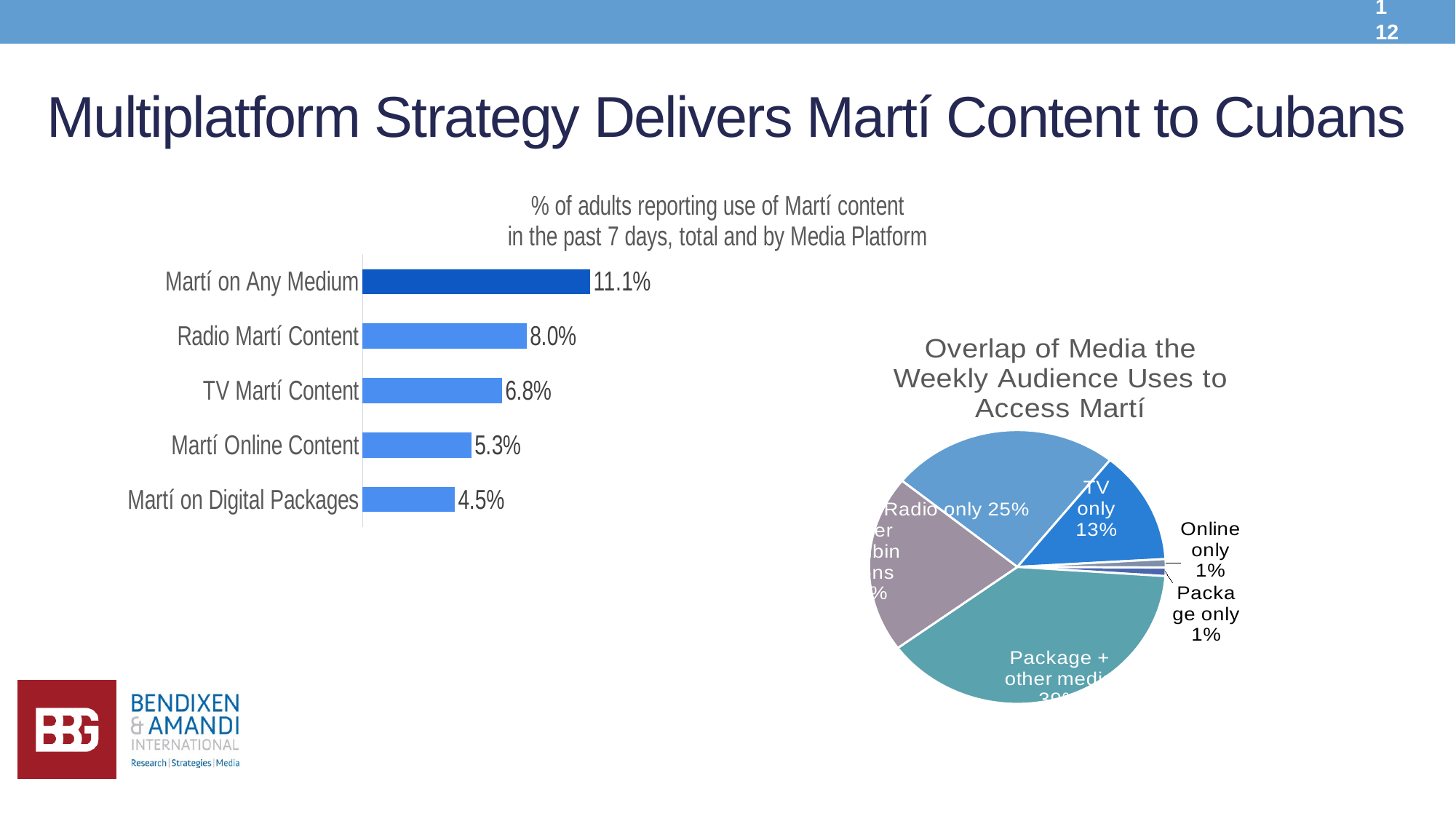
In the bar chart on the left, which category has the highest value? Martí on Any Medium In the pie chart titled 'Overlap of Media the Weekly Audience Uses to Access Martí', what share is Online only? 1% In the bar chart on the left, what is the difference between Radio Martí Content and TV Martí Content? 1.2% In the bar chart on the left, what is the value for Radio Martí Content? 8.0% In the pie chart titled 'Overlap of Media the Weekly Audience Uses to Access Martí', what share is Radio only? 25% What kind of chart is the chart on the left of the slide? Bar chart In the bar chart on the left, what is the value for Martí on Digital Packages? 4.5% In the pie chart titled 'Overlap of Media the Weekly Audience Uses to Access Martí', what share is TV only? 13% In the bar chart on the left, which is larger: TV Martí Content or Martí Online Content? TV Martí Content In the bar chart on the left, which category has the lowest value? Martí on Digital Packages How many categories does the bar chart on the left show? 5 In the bar chart on the left, what is the value for Martí on Any Medium? 11.1%